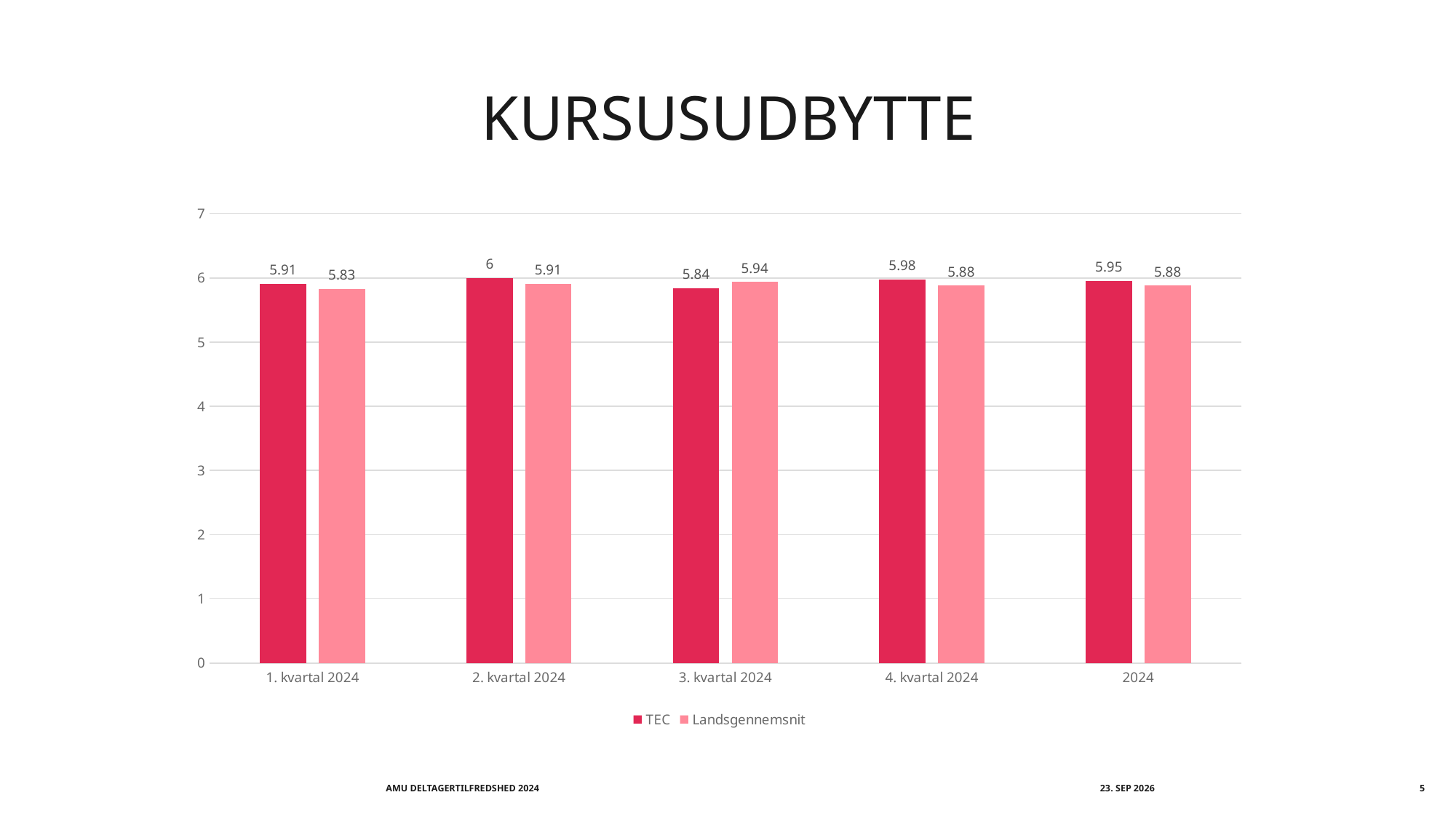
For 3. kvartal 2024, which is larger: TEC or Landsgennemsnit? Landsgennemsnit In which category does TEC reach its highest value? 2. kvartal 2024 What is the TEC value for 1. kvartal 2024? 5.91 What is the Landsgennemsnit value for 4. kvartal 2024? 5.88 What is the Landsgennemsnit value for 3. kvartal 2024? 5.94 What is the TEC value for 2024? 5.95 What type of chart is shown on the slide? Bar chart In which category is the Landsgennemsnit value lowest? 1. kvartal 2024 Is the TEC value for 4. kvartal 2024 greater or less than 5? greater What is the difference between the TEC and Landsgennemsnit values for 2. kvartal 2024? 0.09 How many categories are shown on the x axis? 5 How many series does the legend list? 2